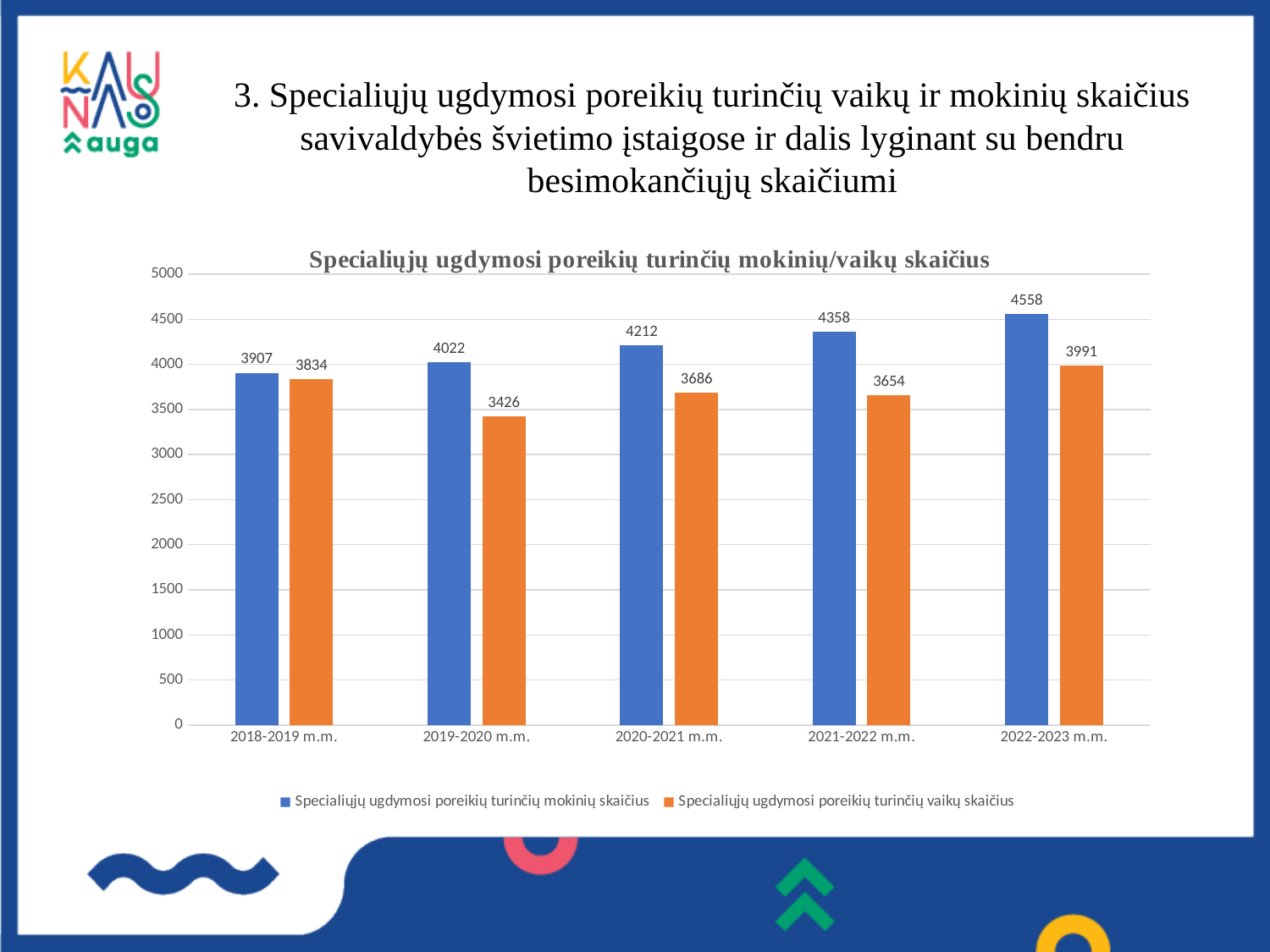
Is the value for 'Specialiųjų ugdymosi poreikių turinčių mokinių skaičius' in 2022-2023 m.m. greater or less than 4500? greater Which is larger in 2018-2019 m.m.: 'Specialiųjų ugdymosi poreikių turinčių mokinių skaičius' or 'Specialiųjų ugdymosi poreikių turinčių vaikų skaičius'? Specialiųjų ugdymosi poreikių turinčių mokinių skaičius How many school years are shown on the x axis? 5 What is the value for 'Specialiųjų ugdymosi poreikių turinčių mokinių skaičius' in 2020-2021 m.m.? 4212 How many series does the legend list? 2 What kind of chart is shown on the slide? bar chart What is the value for 'Specialiųjų ugdymosi poreikių turinčių vaikų skaičius' in 2019-2020 m.m.? 3426 What is the value for 'Specialiųjų ugdymosi poreikių turinčių vaikų skaičius' in 2022-2023 m.m.? 3991 In which school year is 'Specialiųjų ugdymosi poreikių turinčių vaikų skaičius' lowest? 2019-2020 m.m. What is the difference between 'Specialiųjų ugdymosi poreikių turinčių mokinių skaičius' and 'Specialiųjų ugdymosi poreikių turinčių vaikų skaičius' in 2021-2022 m.m.? 704 In which school year is 'Specialiųjų ugdymosi poreikių turinčių mokinių skaičius' highest? 2022-2023 m.m. Does 'Specialiųjų ugdymosi poreikių turinčių mokinių skaičius' rise or fall from 2018-2019 m.m. to 2022-2023 m.m.? rise